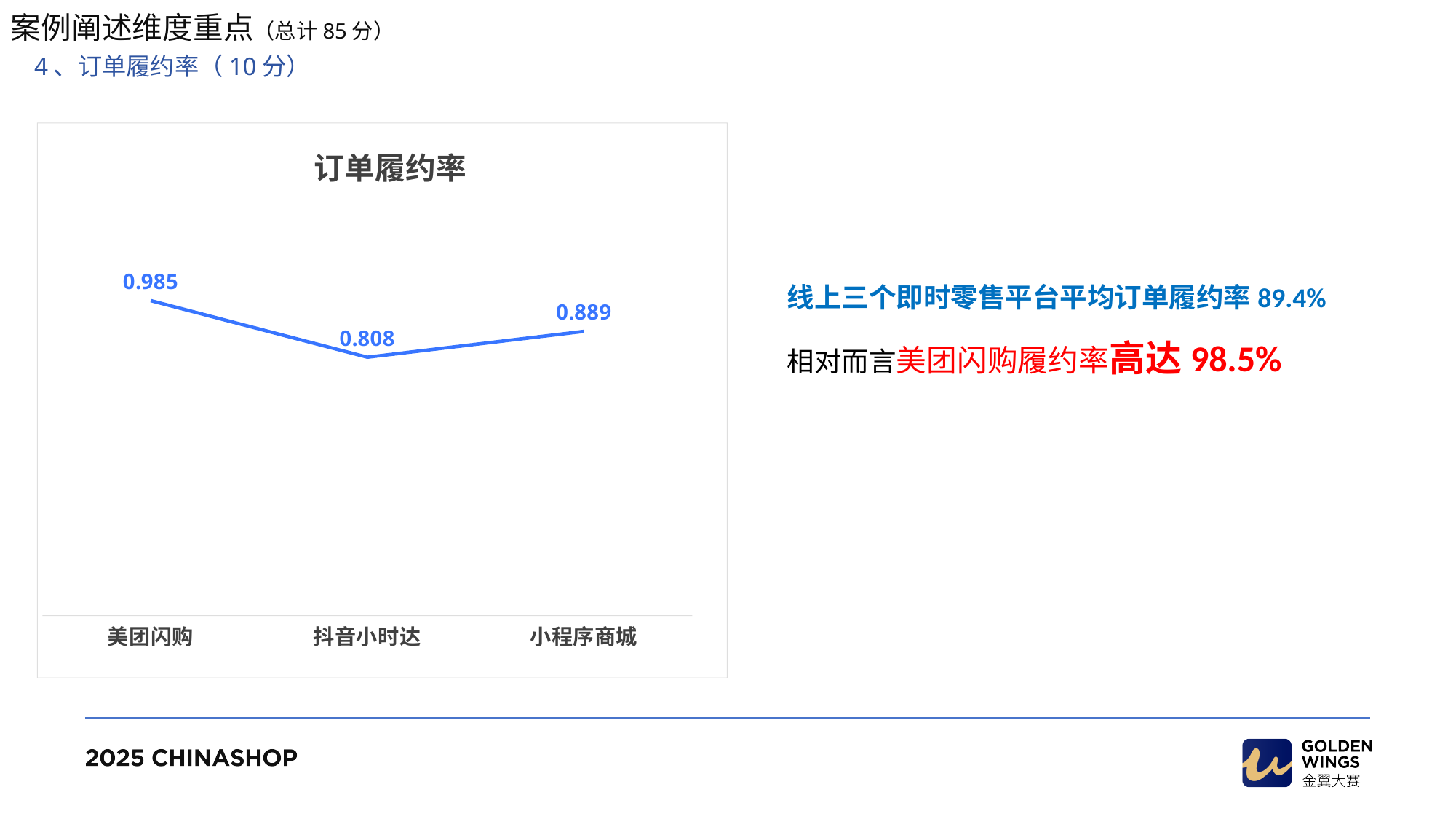
What is the difference between the values for 美团闪购 and 抖音小时达? 0.177 What is the difference between the values for 小程序商城 and 抖音小时达? 0.081 What is the title of the chart on the slide? 订单履约率 What is the value for 抖音小时达 in the 订单履约率 chart? 0.808 Which category has the lowest value in the 订单履约率 chart? 抖音小时达 What kind of chart is shown on the slide? line chart How many categories are plotted in the 订单履约率 chart? 3 What is the value for 美团闪购 in the 订单履约率 chart? 0.985 Does the line fall or rise from 美团闪购 to 抖音小时达? fall Which category has the highest value in the 订单履约率 chart? 美团闪购 What is the value for 小程序商城 in the 订单履约率 chart? 0.889 Which is larger, the value for 美团闪购 or the value for 小程序商城? 美团闪购